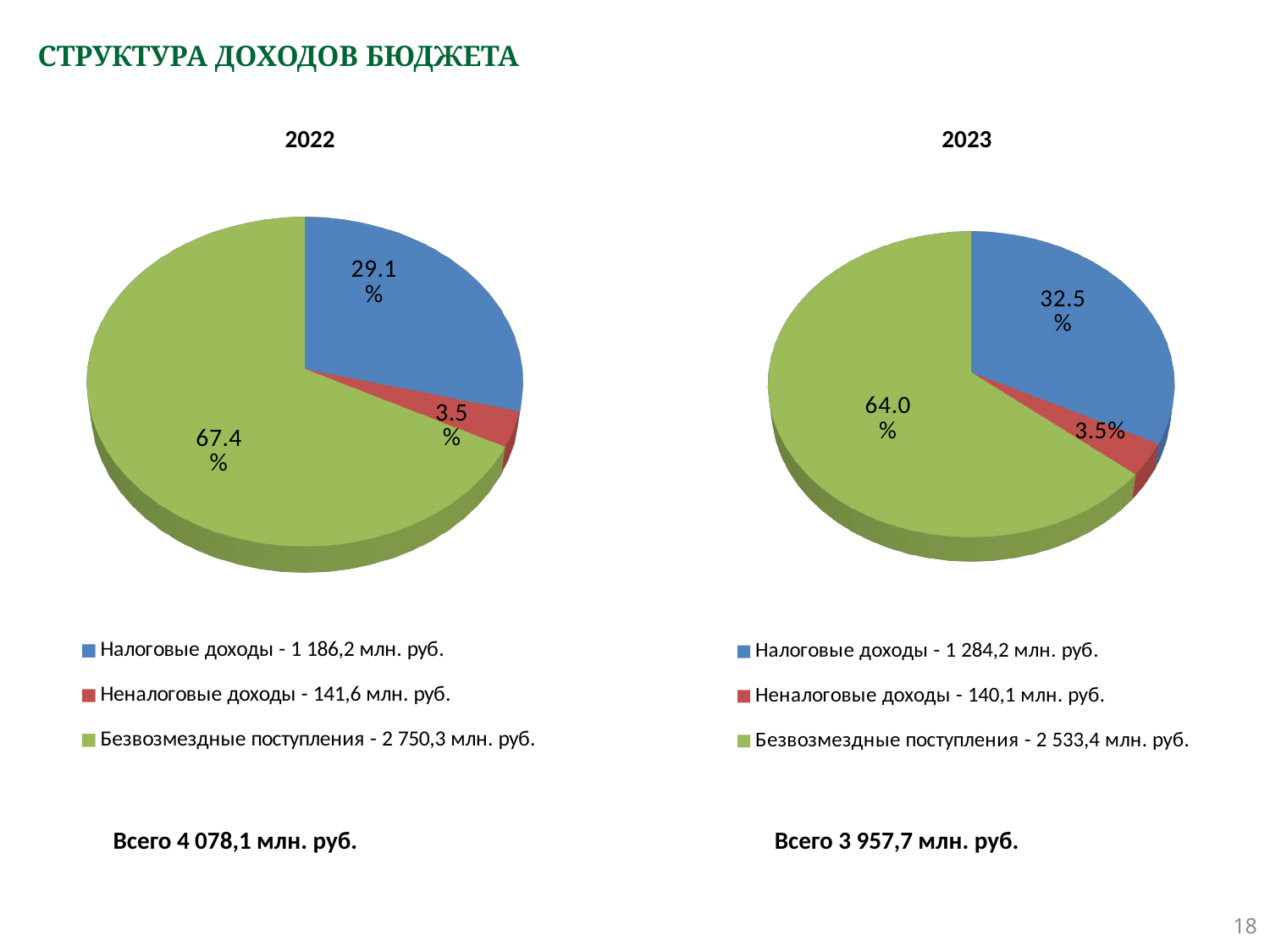
In the 2022 chart, what is the difference in percentage points between the Безвозмездные поступления slice and the Налоговые доходы slice? 38.3 In the 2022 chart, which category has the largest slice? Безвозмездные поступления What is the title of the chart on the right? 2023 Which is larger: the Налоговые доходы share in the 2022 chart or in the 2023 chart? 2023 In the 2023 chart, which category has the smallest slice? Неналоговые доходы In the 2022 chart, what share does Безвозмездные поступления have? 67.4% How many entries does the legend of the 2023 chart list? 3 In the 2023 chart, what colour is the Безвозмездные поступления slice? green In the 2023 chart, what share does Неналоговые доходы have? 3.5% How many slices does the 2022 pie chart have? 3 What type of chart is the 2022 chart? pie chart In the 2023 chart, what share does Налоговые доходы have? 32.5%